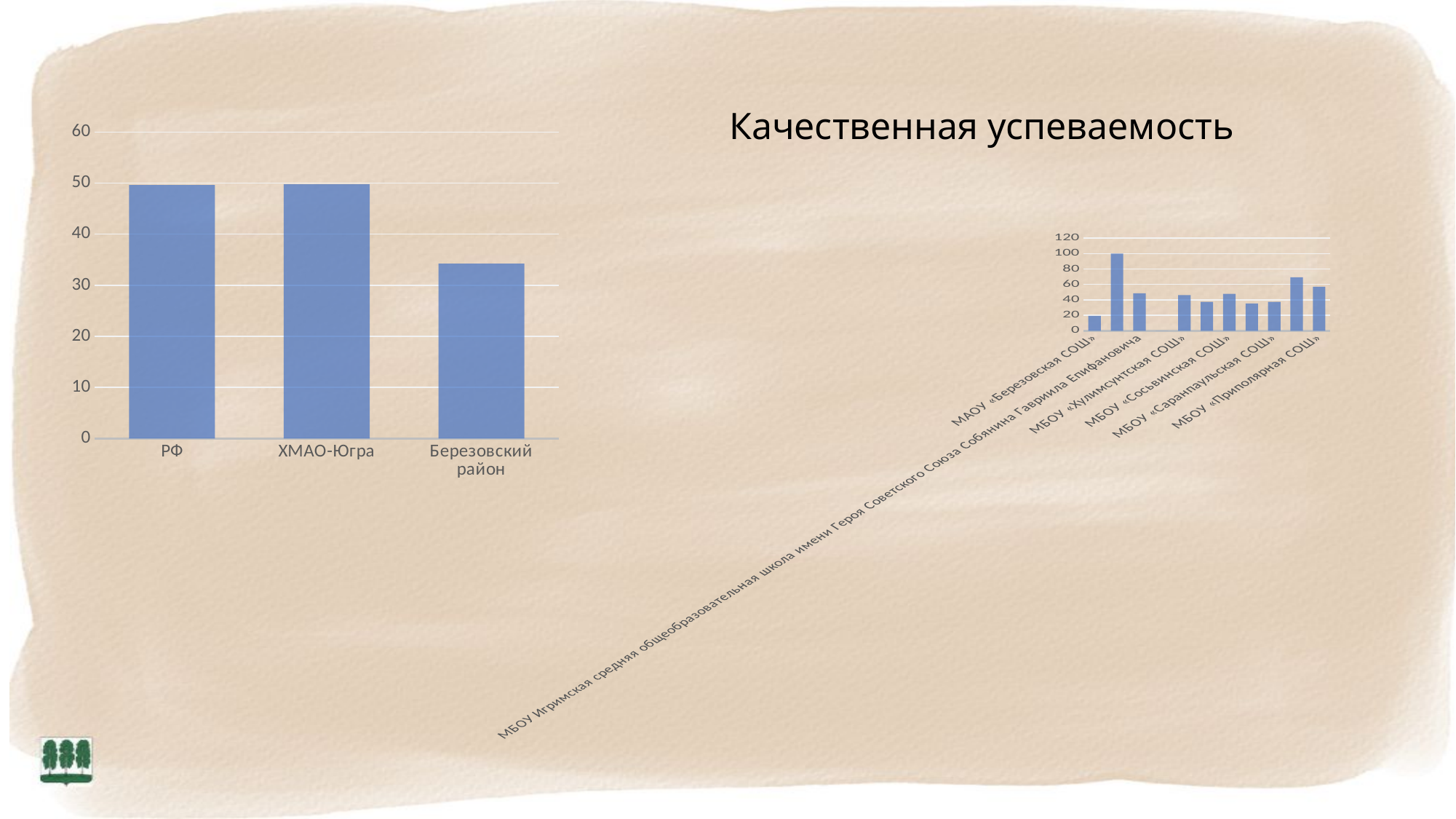
How many categories does the left chart show? 3 In the left chart, is the value for ХМАО-Югра greater or less than 30? greater In the left chart, which is larger: the value for ХМАО-Югра or the value for Березовский район? ХМАО-Югра In the left chart, is the value for РФ greater or less than 40? greater How many bars does the right chart show? 10 In the left chart, which category has the lowest value? Березовский район In the left chart, which is larger: the value for РФ or the value for Березовский район? РФ What is the title shown on the slide above the right chart? Качественная успеваемость What kind of chart is the right chart on the slide? bar chart What is the highest tick value on the vertical axis of the right chart? 120 In the left chart, is the value for Березовский район greater or less than 40? less What kind of chart is the left chart on the slide? bar chart